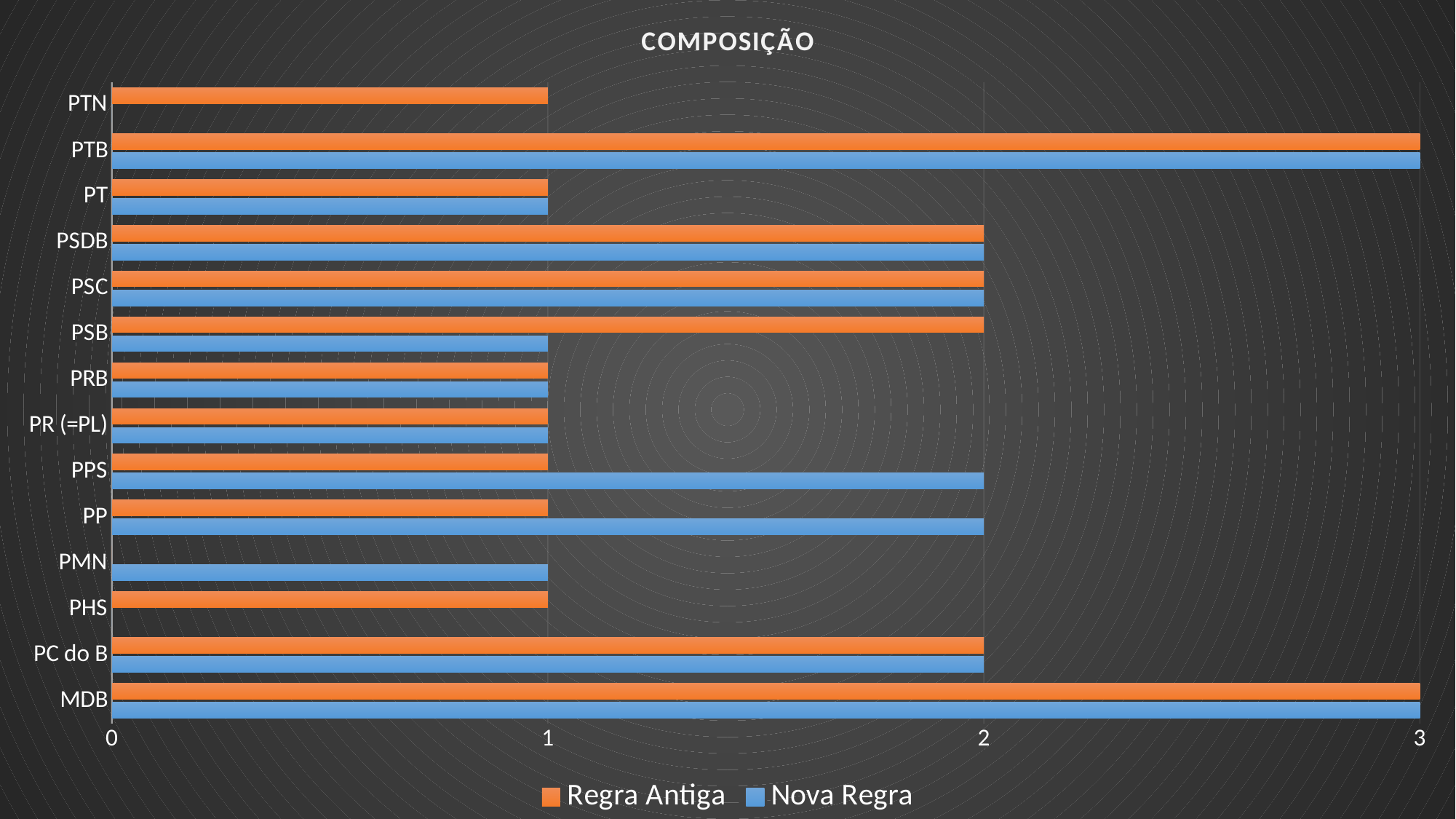
Which series is shown in orange? Regra Antiga What is the Regra Antiga value for PSDB? 2 How many series does the legend list? 2 What is the difference between the Nova Regra and Regra Antiga values for PPS? 1 What kind of chart is shown on the slide? Bar chart What is the Nova Regra value for PSB? 1 What is the Nova Regra value for PP? 2 What is the Regra Antiga value for PTB? 3 For PSB, which is larger: the Regra Antiga value or the Nova Regra value? Regra Antiga What is the title of the chart? COMPOSIÇÃO Is the Regra Antiga value for MDB greater or less than 2? greater How many categories (parties) are shown on the chart? 14